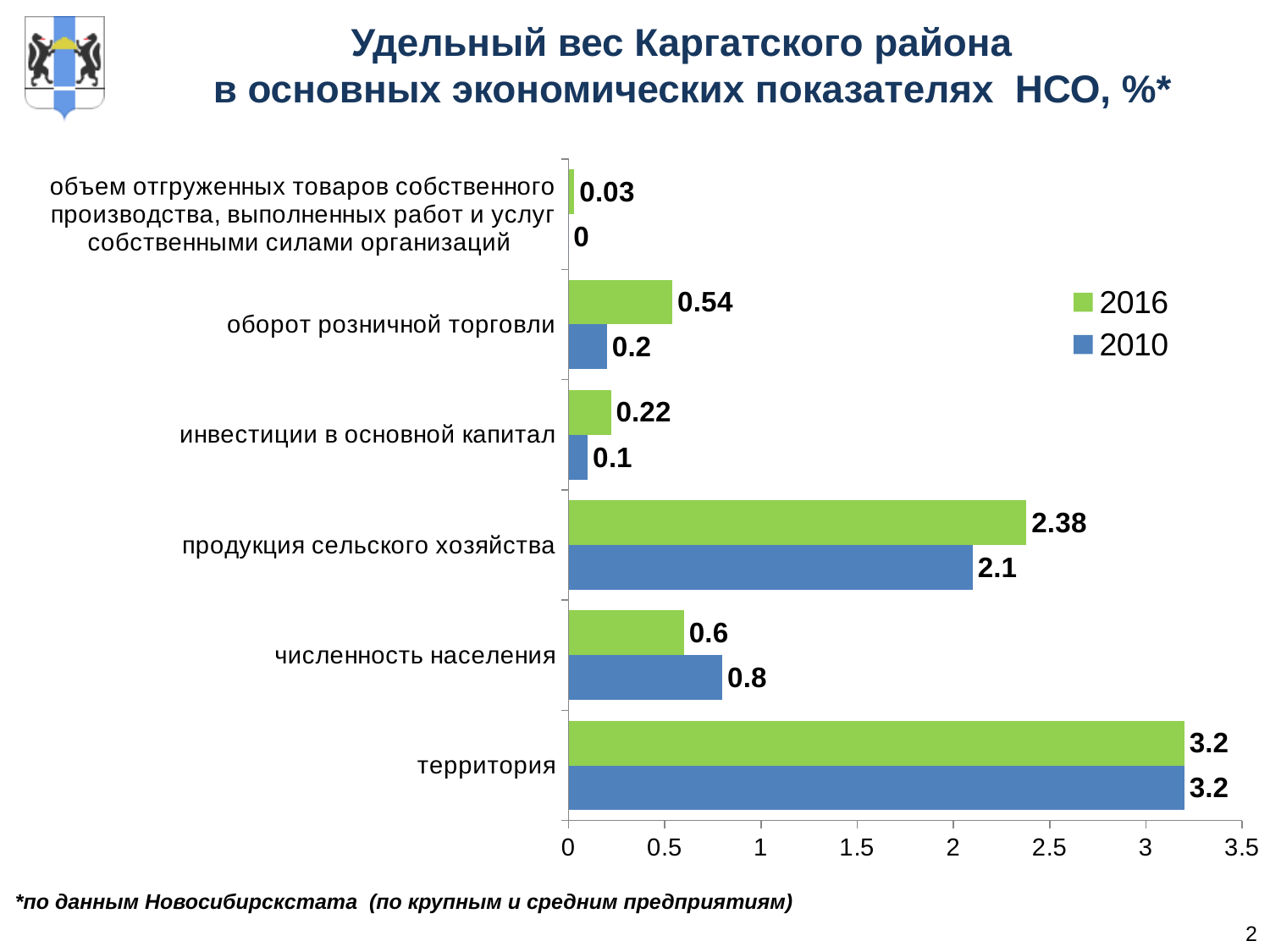
Which colour represents the 2016 series? green What kind of chart is shown on the slide? bar chart Which is larger for численность населения: the 2016 value or the 2010 value? 2010 How many series does the legend list? 2 How many categories are shown on the chart? 6 What is the value for 2016 for оборот розничной торговли? 0.54 What is the difference between the 2016 and 2010 values for оборот розничной торговли? 0.34 What is the value for 2016 for продукция сельского хозяйства? 2.38 What is the value for 2010 for численность населения? 0.8 Which category has the highest value for 2016? территория Which category has the lowest value for 2010? объем отгруженных товаров собственного производства, выполненных работ и услуг собственными силами организаций What is the value for 2010 for инвестиции в основной капитал? 0.1